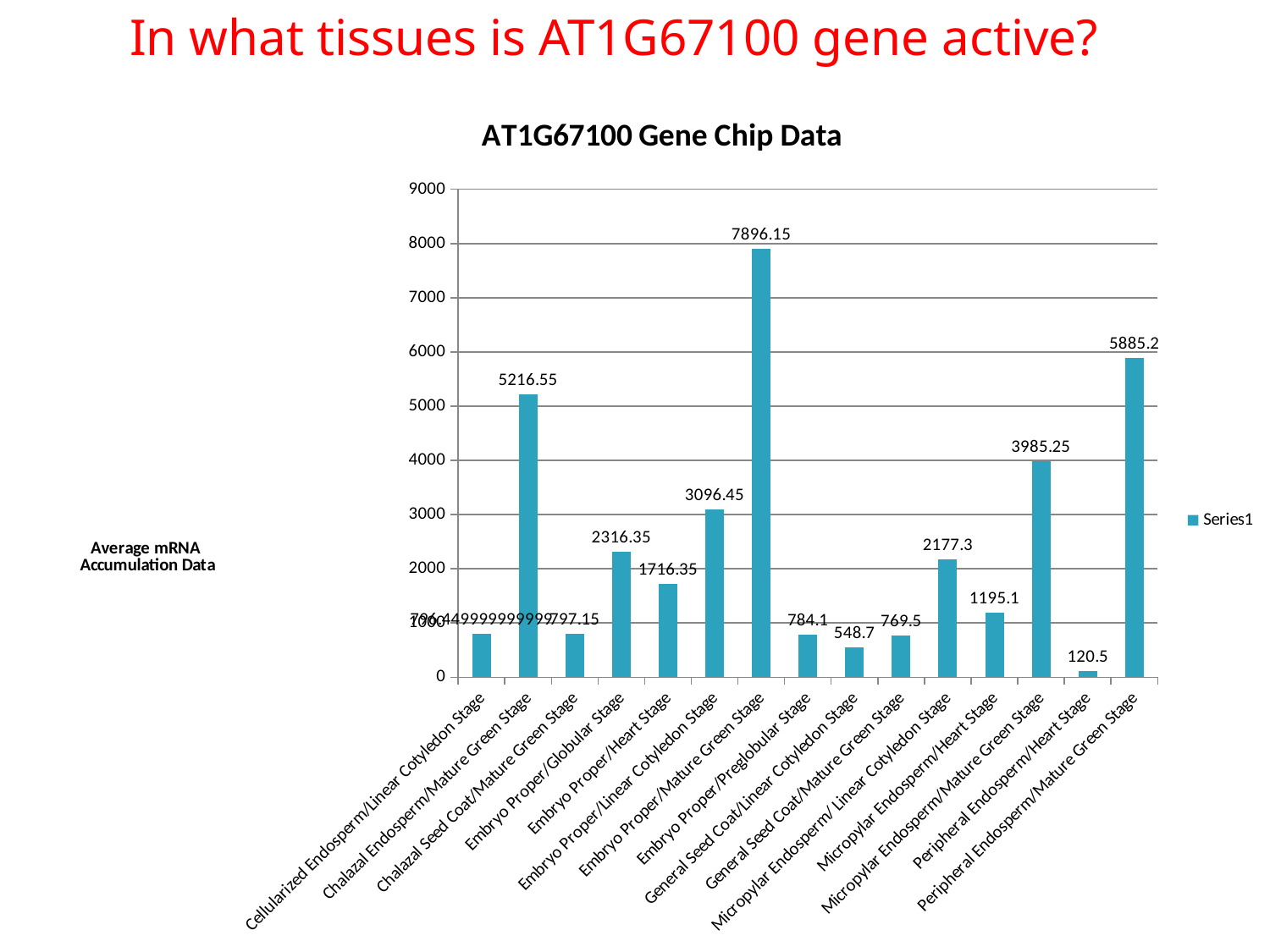
Which is larger, the value for Micropylar Endosperm/Mature Green Stage or the value for Embryo Proper/Linear Cotyledon Stage? Micropylar Endosperm/Mature Green Stage What is the difference between the values for Embryo Proper/Globular Stage and Embryo Proper/Heart Stage? 600 What is the difference between the values for Embryo Proper/Mature Green Stage and Peripheral Endosperm/Mature Green Stage? 2010.95 What type of chart is shown on the slide? Bar chart Which category has the highest value? Embryo Proper/Mature Green Stage What is the value for Embryo Proper/Mature Green Stage? 7896.15 What is the value for Micropylar Endosperm/Heart Stage? 1195.1 What is the value for General Seed Coat/Linear Cotyledon Stage? 548.7 What is the value for Chalazal Endosperm/Mature Green Stage? 5216.55 How many series does the legend list? 1 What is the title of the chart? AT1G67100 Gene Chip Data Which category has the lowest value? Peripheral Endosperm/Heart Stage